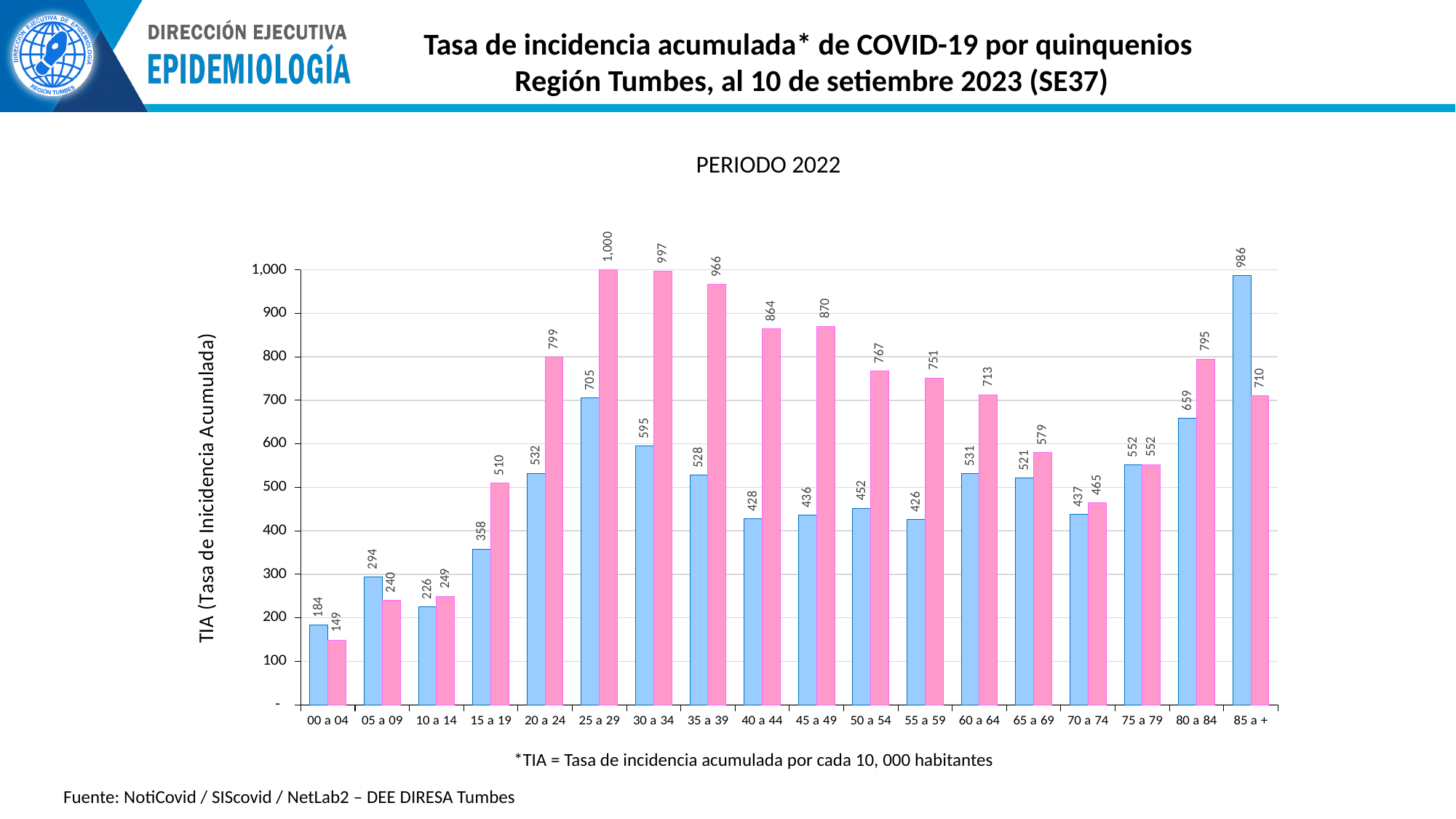
What is the value of the blue bar for the 25 a 29 age group? 705 Which age group has the highest blue bar? 85 a + For the 85 a + age group, which is larger, the blue bar or the pink bar? the blue bar How many age groups are shown on the x axis? 18 Which age group has the lowest blue bar? 00 a 04 What is the value of the pink bar for the 00 a 04 age group? 149 What kind of chart is shown on the slide? bar chart What is the value of the blue bar for the 75 a 79 age group? 552 What is the title shown above the chart? PERIODO 2022 What is the value of the pink bar for the 45 a 49 age group? 870 What is the difference between the pink bar and the blue bar for the 20 a 24 age group? 267 Which age group has the highest pink bar? 25 a 29